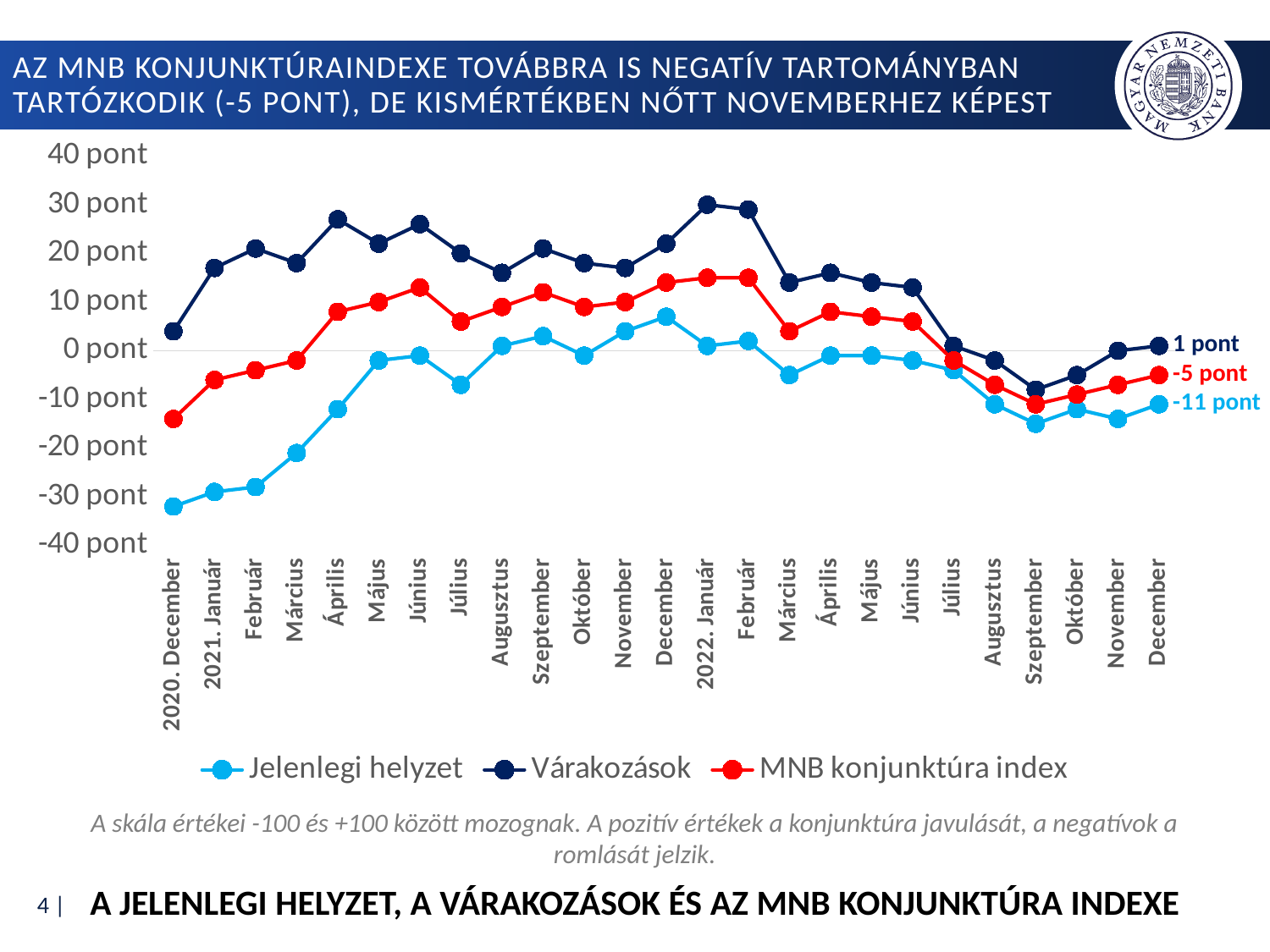
Is the value of Várakozások in 2022. Január greater or less than 20 pont? greater Is the value of Jelenlegi helyzet in 2020. December greater or less than -30 pont? less How many series does the legend list? 3 Which series has the lowest value in 2020. December? Jelenlegi helyzet How many months (data points) are shown along the x axis? 25 In December 2022, which series has the higher value: Várakozások or Jelenlegi helyzet? Várakozások What is the value of the Jelenlegi helyzet series in December 2022? -11 pont What is the value of the Várakozások series in December 2022? 1 pont In December 2022, what is the difference between the Várakozások value and the Jelenlegi helyzet value? 12 pont What kind of chart is shown on the slide? line chart What is the value of the MNB konjunktúra index in December 2022? -5 pont Does the Jelenlegi helyzet series rise or fall from 2020. December to 2021 Június? rise